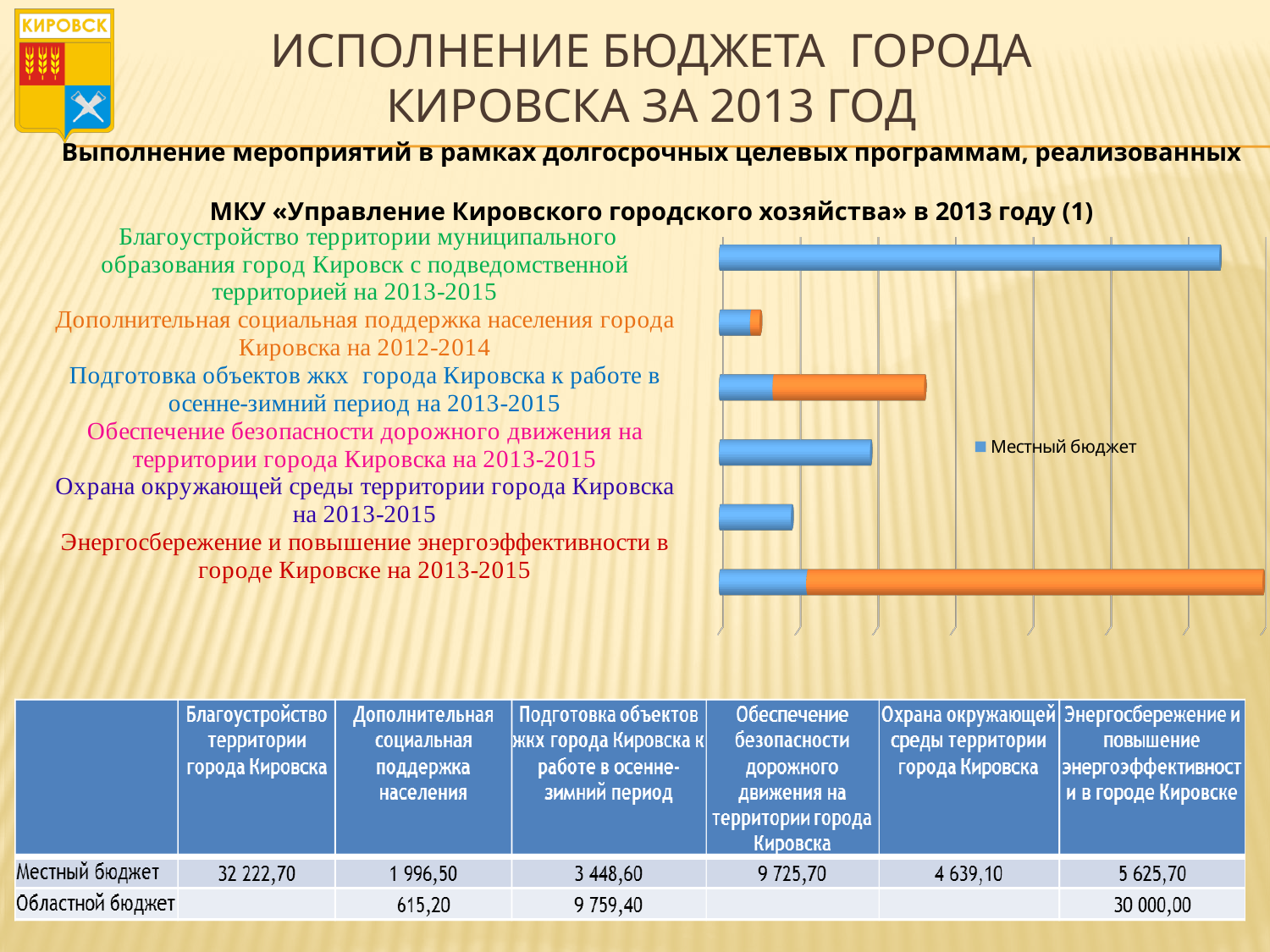
Which series name is shown in the chart legend? Местный бюджет What is the total of the stacked bar for Энергосбережение и повышение энергоэффективности в городе Кировске (Местный бюджет plus Областной бюджет)? 35 625,70 Which category has the lowest value of Местный бюджет? Дополнительная социальная поддержка населения What is the value of Местный бюджет for Благоустройство территории города Кировска? 32 222,70 What kind of chart is shown on the slide? Bar chart What is the value of Областной бюджет for Энергосбережение и повышение энергоэффективности в городе Кировске? 30 000,00 How many categories (programmes) are plotted in the chart? 6 What is the value of Областной бюджет for Подготовка объектов жкх города Кировска к работе в осенне-зимний период? 9 759,40 What is the difference between the Местный бюджет values for Обеспечение безопасности дорожного движения на территории города Кировска and Охрана окружающей среды территории города Кировска? 5 086,60 Which is larger: the Местный бюджет value for Энергосбережение и повышение энергоэффективности в городе Кировске or for Охрана окружающей среды территории города Кировска? Энергосбережение и повышение энергоэффективности в городе Кировске Which category has the highest value of Местный бюджет? Благоустройство территории города Кировска What is the total of the stacked bar for Подготовка объектов жкх города Кировска к работе в осенне-зимний период (Местный бюджет plus Областной бюджет)? 13 208,00